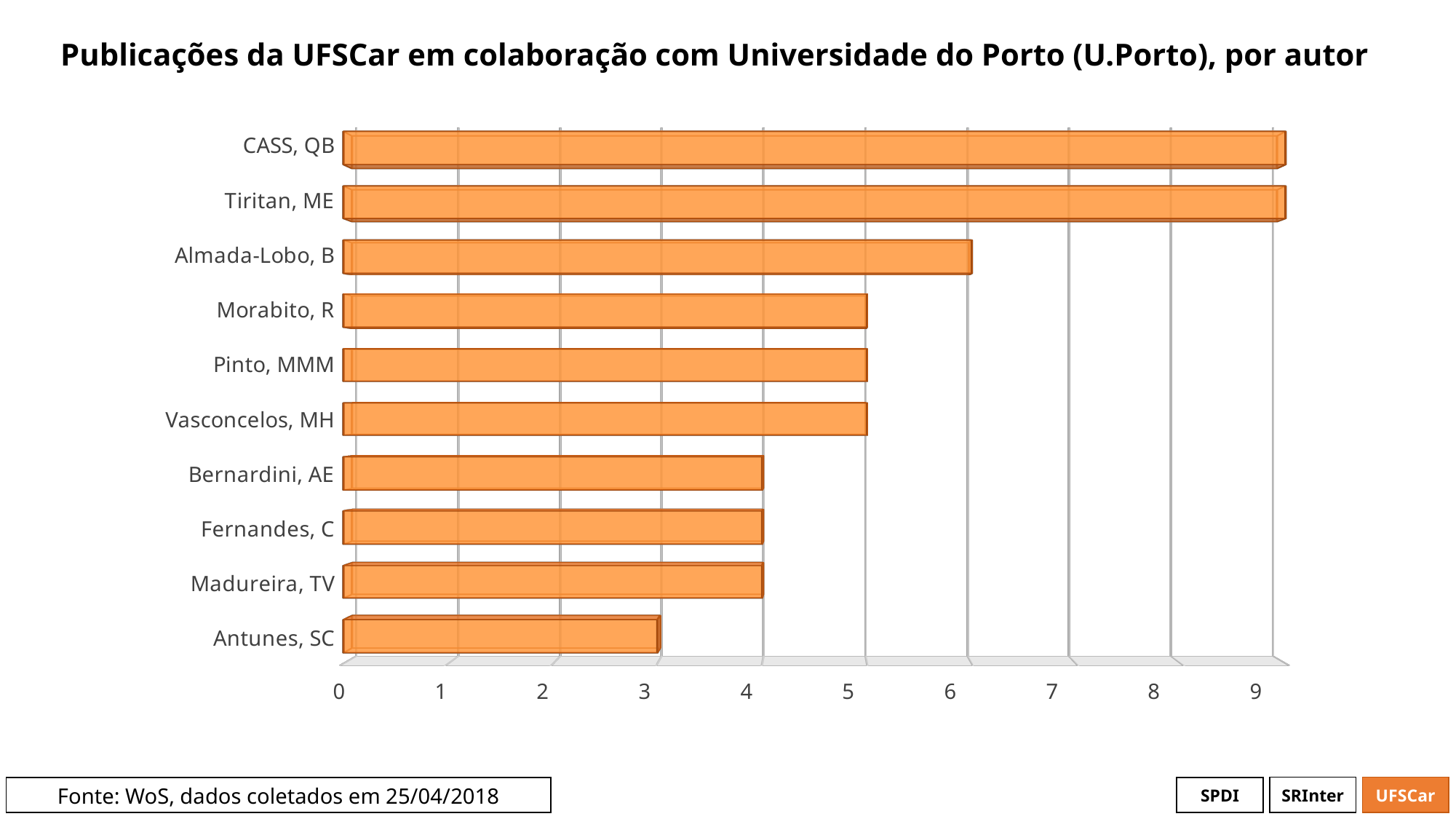
What is the value for Antunes, SC? 3 Which is larger, the value for Almada-Lobo, B or the value for Pinto, MMM? Almada-Lobo, B Is the value for Tiritan, ME greater or less than 8? greater How many authors are listed in the chart? 10 What is the value for Morabito, R? 5 What is the value for Bernardini, AE? 4 What is the title of the chart? Publicações da UFSCar em colaboração com Universidade do Porto (U.Porto), por autor What type of chart is shown on the slide? bar chart What is the difference between the values for Almada-Lobo, B and Antunes, SC? 3 What is the value for Almada-Lobo, B? 6 Which author has the lowest number of publications? Antunes, SC What is the difference between the values for CASS, QB and Madureira, TV? 5